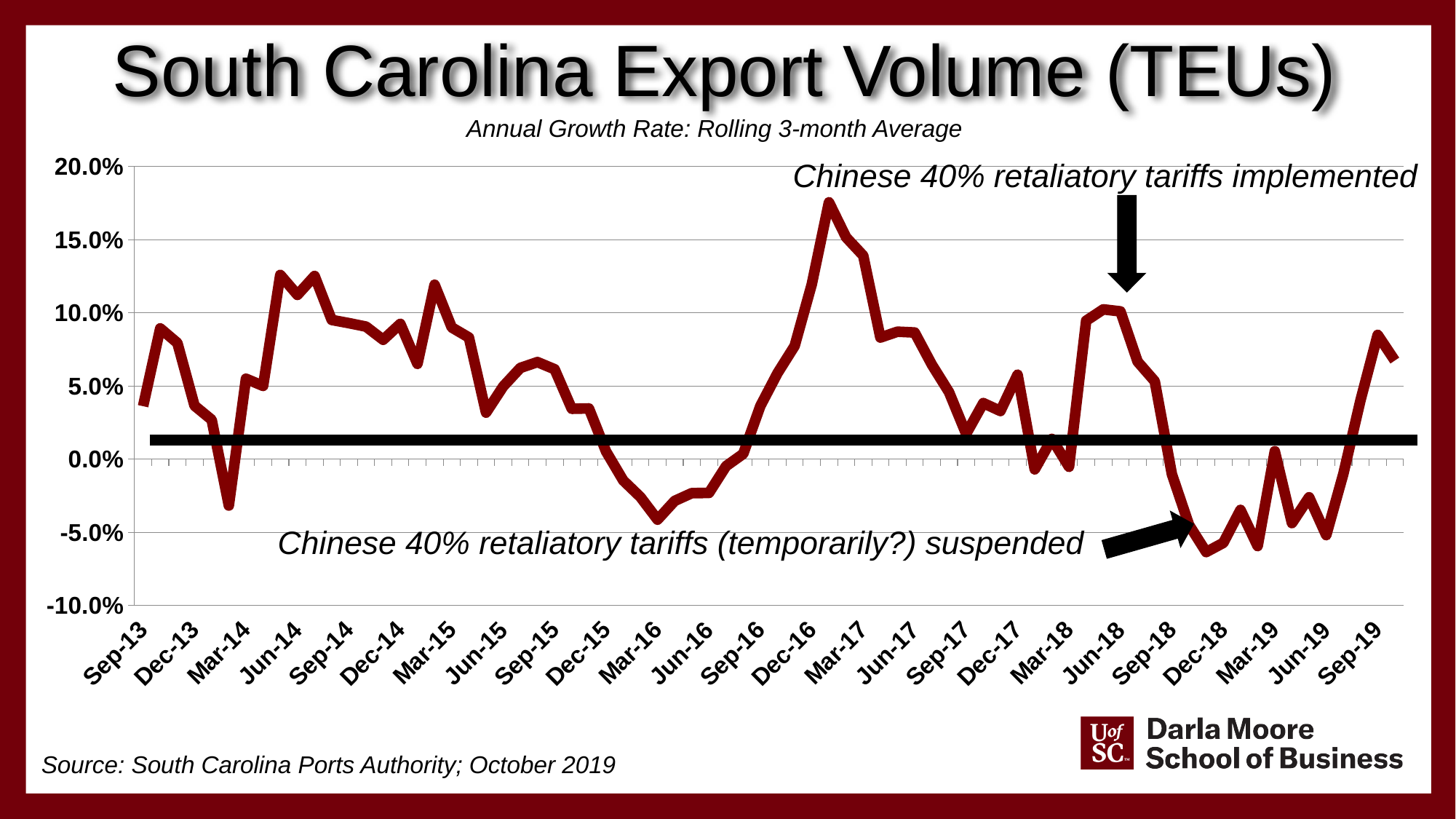
Is the value at Mar-16 greater or less than 0.0%? less Do the values rise or fall between Mar-17 and Sep-17? fall What is the title of the chart? South Carolina Export Volume (TEUs) Is the value at Jun-14 greater or less than 10.0%? greater Do the values rise or fall between Mar-16 and Dec-16? rise What kind of chart is shown on the slide? Line chart Is the value at Dec-18 greater or less than -5.0%? less Which is larger, the value at Mar-17 or the value at Jun-14? Mar-17 What does the subtitle say the chart measures? Annual Growth Rate: Rolling 3-month Average